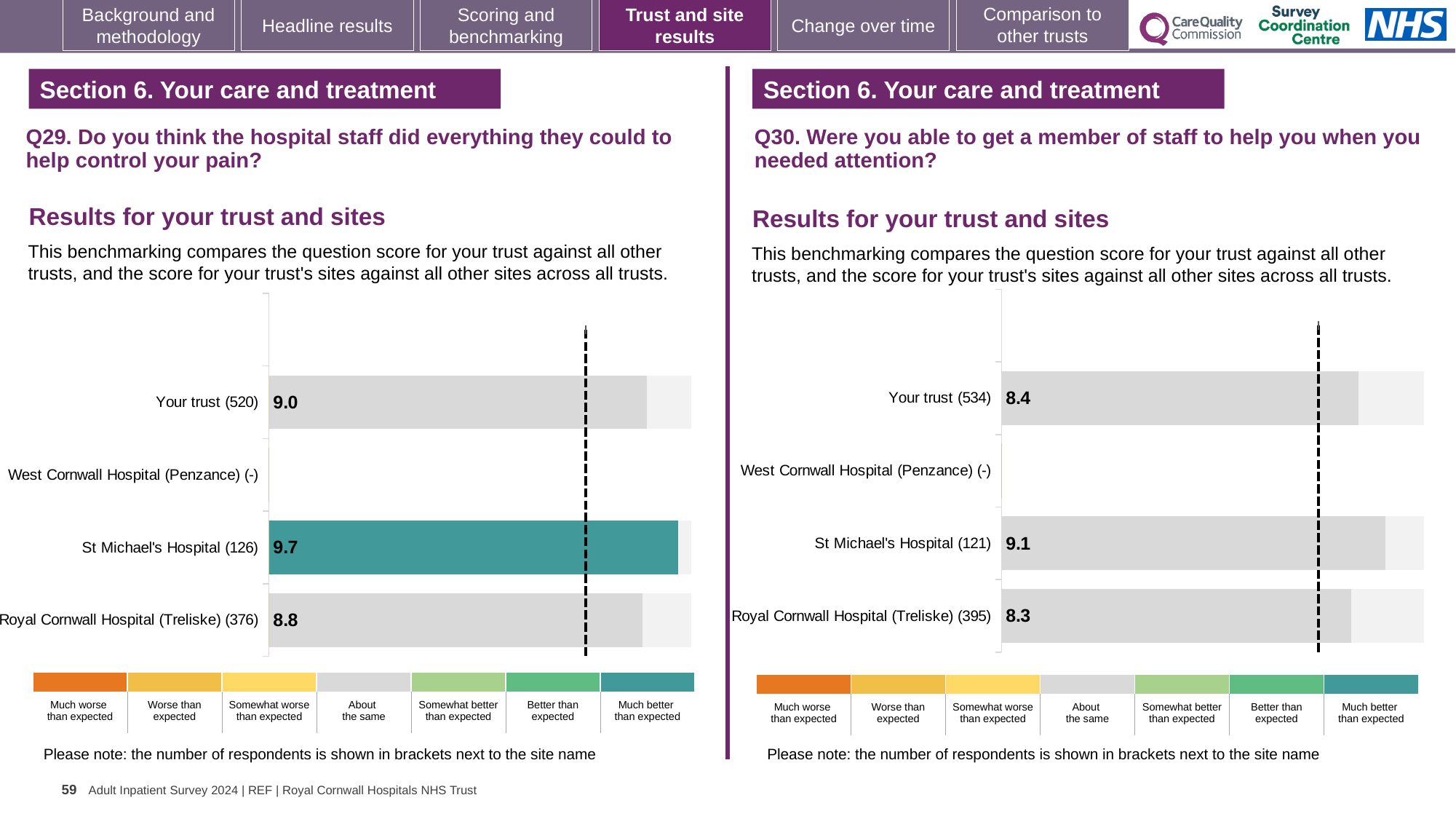
On the Q29 chart (left), what is the score for Royal Cornwall Hospital (Treliske)? 8.8 On the Q30 chart (right), what is the score for St Michael's Hospital? 9.1 On the Q30 chart (right), what is the difference between the scores for St Michael's Hospital and Your trust? 0.7 On the Q30 chart (right), what is the score for Royal Cornwall Hospital (Treliske)? 8.3 On the Q29 chart (left), what is the score for St Michael's Hospital? 9.7 On the Q29 chart (left), what is the score for Your trust? 9.0 What kind of chart is used on the Q29 chart (left)? Bar chart On the Q30 chart (right), which is larger: the score for Your trust or the score for St Michael's Hospital? St Michael's Hospital On the Q29 chart (left), how many respondents are shown in brackets for St Michael's Hospital? 126 On the Q29 chart (left), what is the difference between the scores for St Michael's Hospital and Royal Cornwall Hospital (Treliske)? 0.9 On the Q29 chart (left), which site has the highest score? St Michael's Hospital On the Q30 chart (right), what is the score for Your trust? 8.4